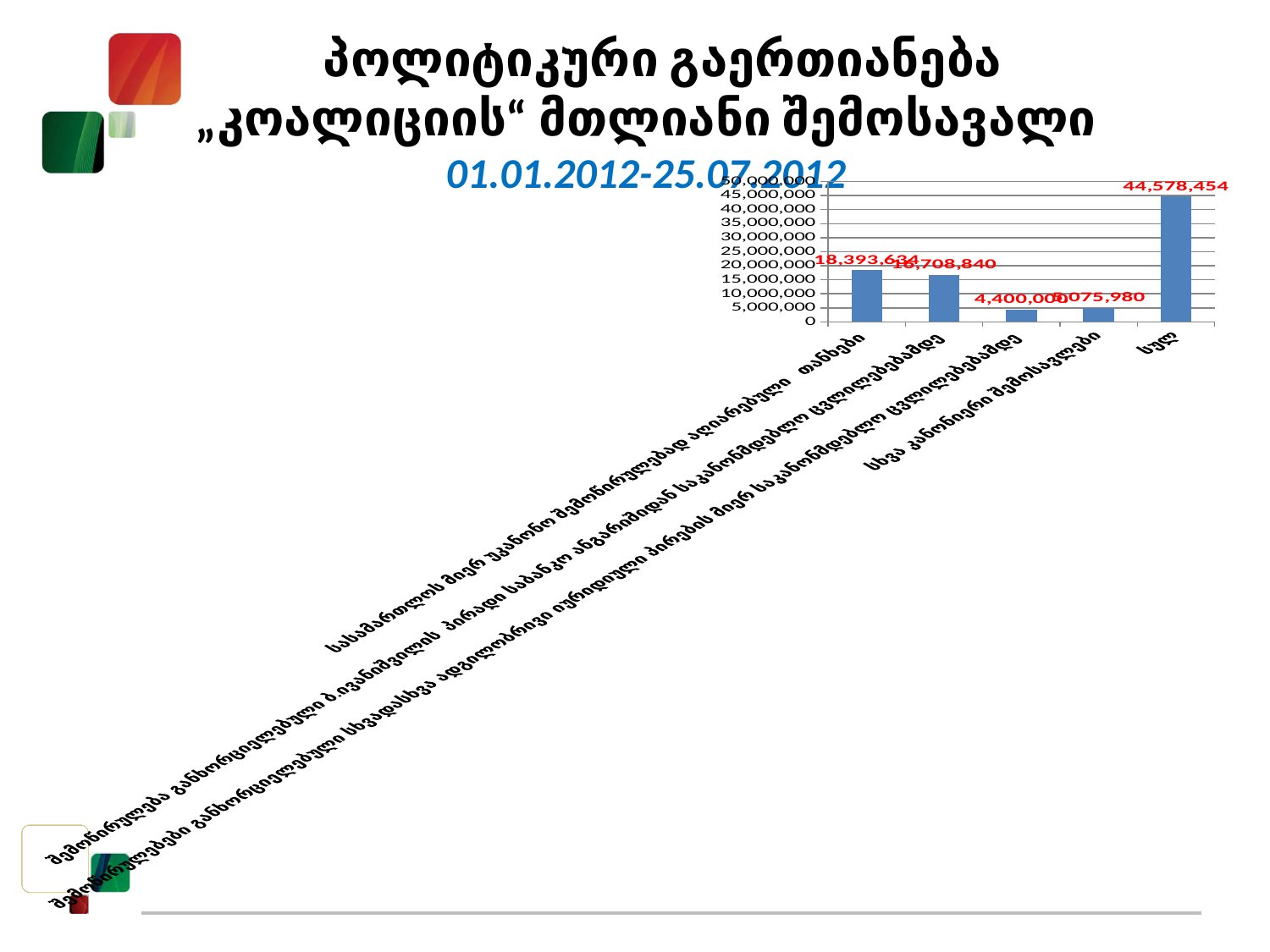
What is the value for სულ? 44,578,454 What is the smallest value shown on the chart? 4,400,000 What date range is shown in the slide title? 01.01.2012-25.07.2012 What is the value of the second bar from the left? 16,708,840 What is the value of the first (leftmost) bar? 18,393,634 How many bars does the chart show? 5 Is the value for სულ greater or less than 40,000,000? greater Which is larger, the first bar or the second bar from the left? the first bar (18,393,634) What is the value for სხვა კანონიერი შემოსავლები? 5,075,980 What is the difference between სულ and სხვა კანონიერი შემოსავლები? 39,502,474 Which category has the highest value? სულ What kind of chart is shown on the slide? bar chart